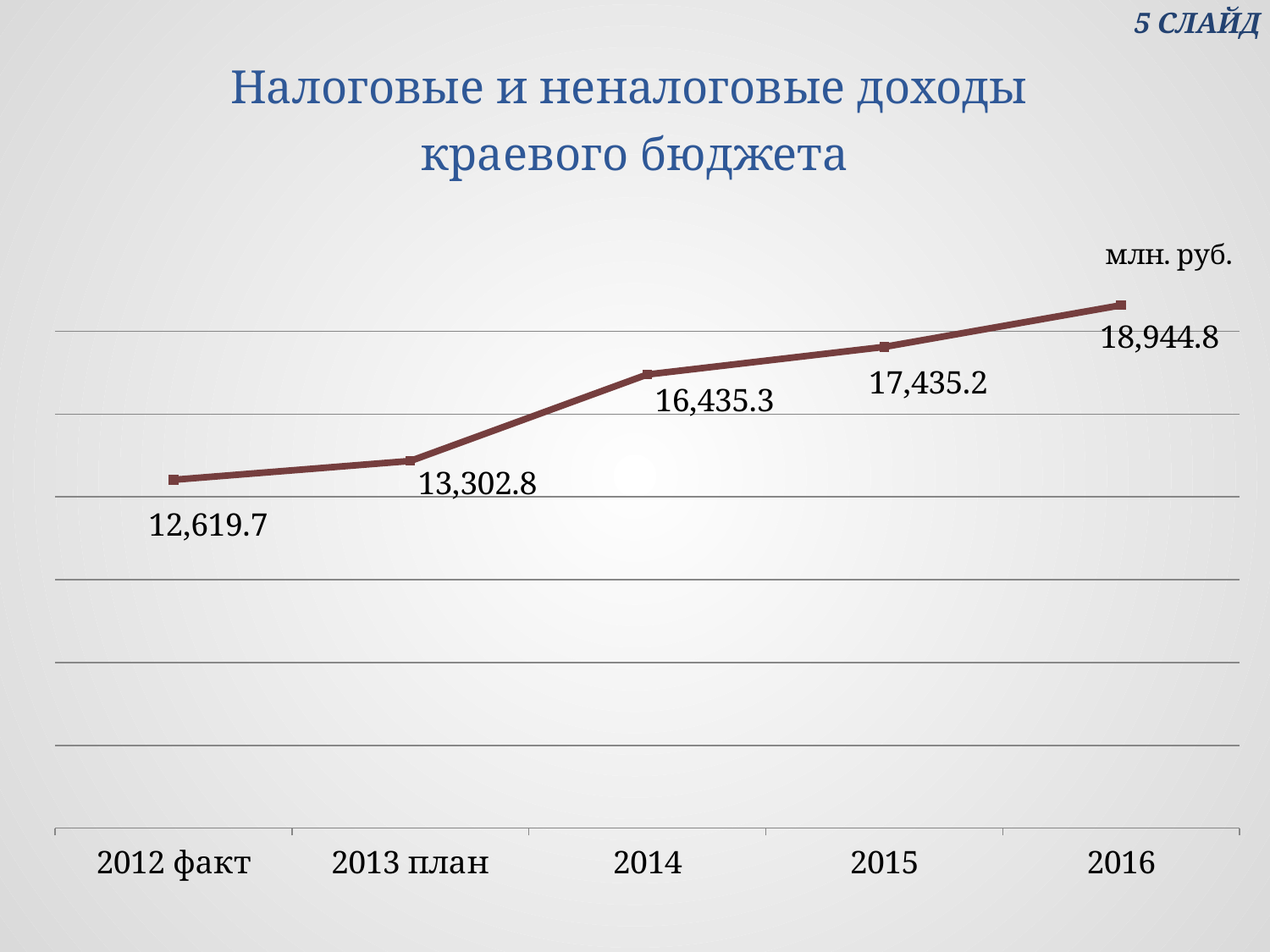
What is the value for 2016? 18,944.8 Which category has the lowest value? 2012 факт How many data points are plotted on the chart? 5 What is the value for 2014? 16,435.3 What is the value for 2013 план? 13,302.8 Which is larger, the value for 2015 or the value for 2014? 2015 What kind of chart is shown on the slide? line chart What is the difference between the values for 2014 and 2013 план? 3,132.5 Do the values rise or fall from 2012 факт to 2016? rise What is the difference between the values for 2016 and 2015? 1,509.6 Which year has the highest value? 2016 What is the value for 2012 факт? 12,619.7